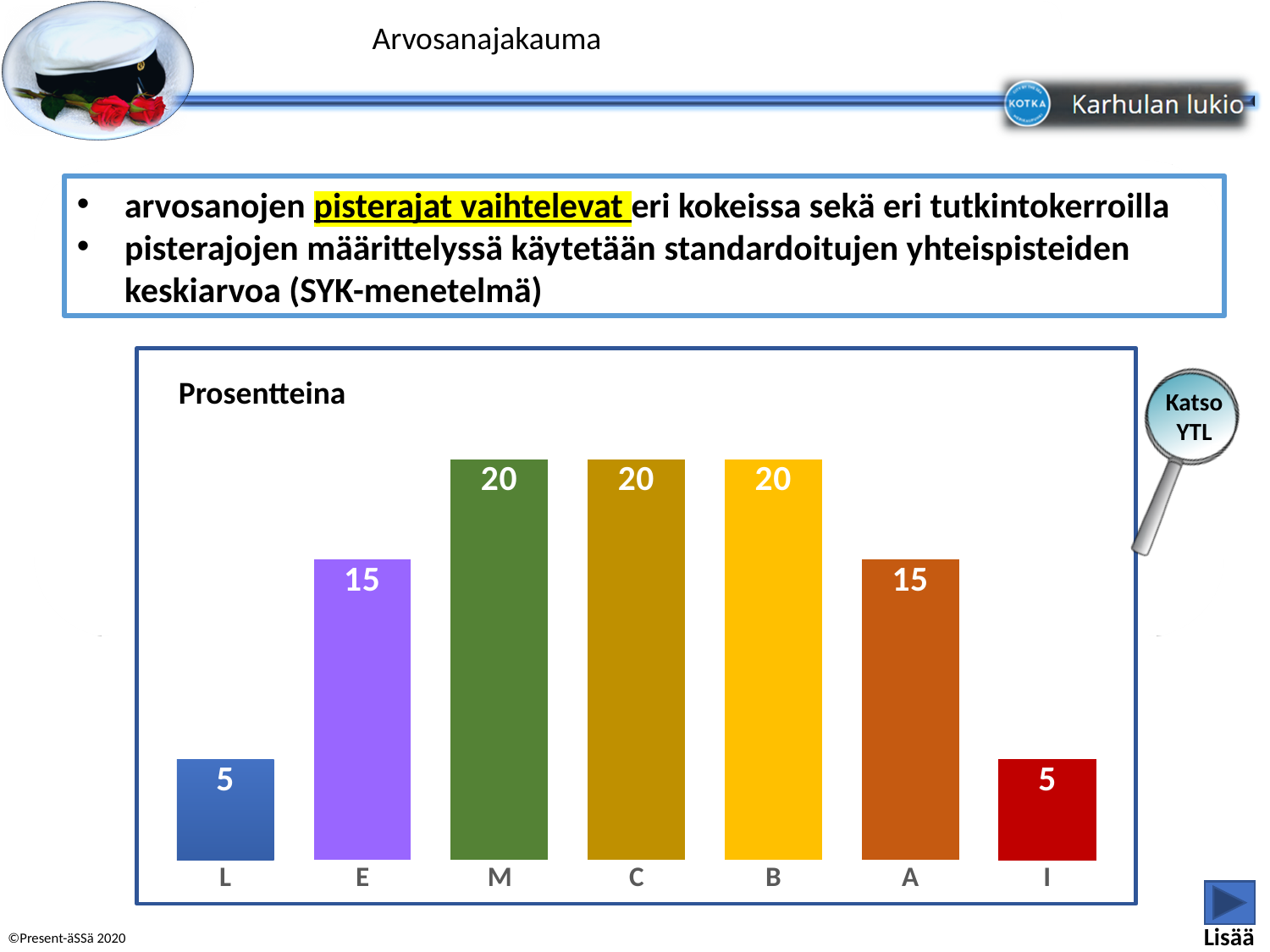
What is the value for category A in the chart? 15 Which is larger, the value for L or the value for A? A What kind of chart is shown on the slide? bar chart Which is larger, the value for E or the value for C? C What is the title shown above the chart? Prosentteina What is the value for category L in the chart? 5 What is the difference between the value for M and the value for E? 5 How many categories are shown in the chart? 7 What is the difference between the value for B and the value for I? 15 What is the value for category M in the chart? 20 What is the value for category I in the chart? 5 What is the value for category E in the chart? 15